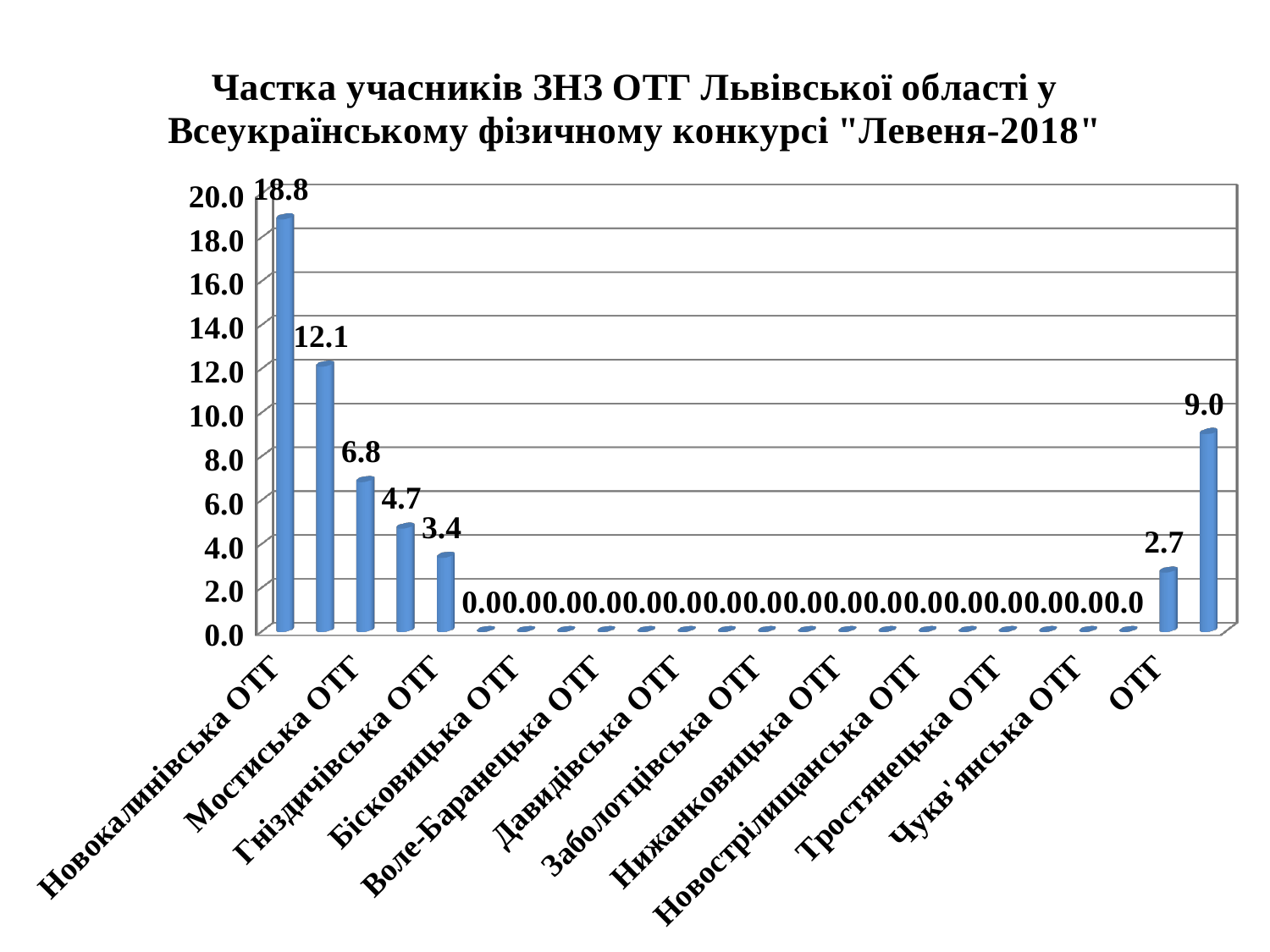
Which is larger: the second bar from the left (12.1) or the rightmost bar (9.0)? the second bar from the left (12.1) What is the value of the second bar from the left? 12.1 What is the value for Новокалинівська ОТГ? 18.8 What is the highest value shown in the chart? 18.8 What is the difference between the highest value (18.8) and the second-highest value (12.1)? 6.7 What is the highest tick value on the vertical axis? 20.0 What is the lowest value shown in the chart? 0.0 What is the value of the rightmost bar in the chart? 9.0 Is the value of the rightmost bar greater or less than 8.0? greater Which category has the highest value in the chart? Новокалинівська ОТГ What kind of chart is shown on the slide? bar chart What is the difference between the value for Новокалинівська ОТГ (18.8) and the rightmost bar (9.0)? 9.8